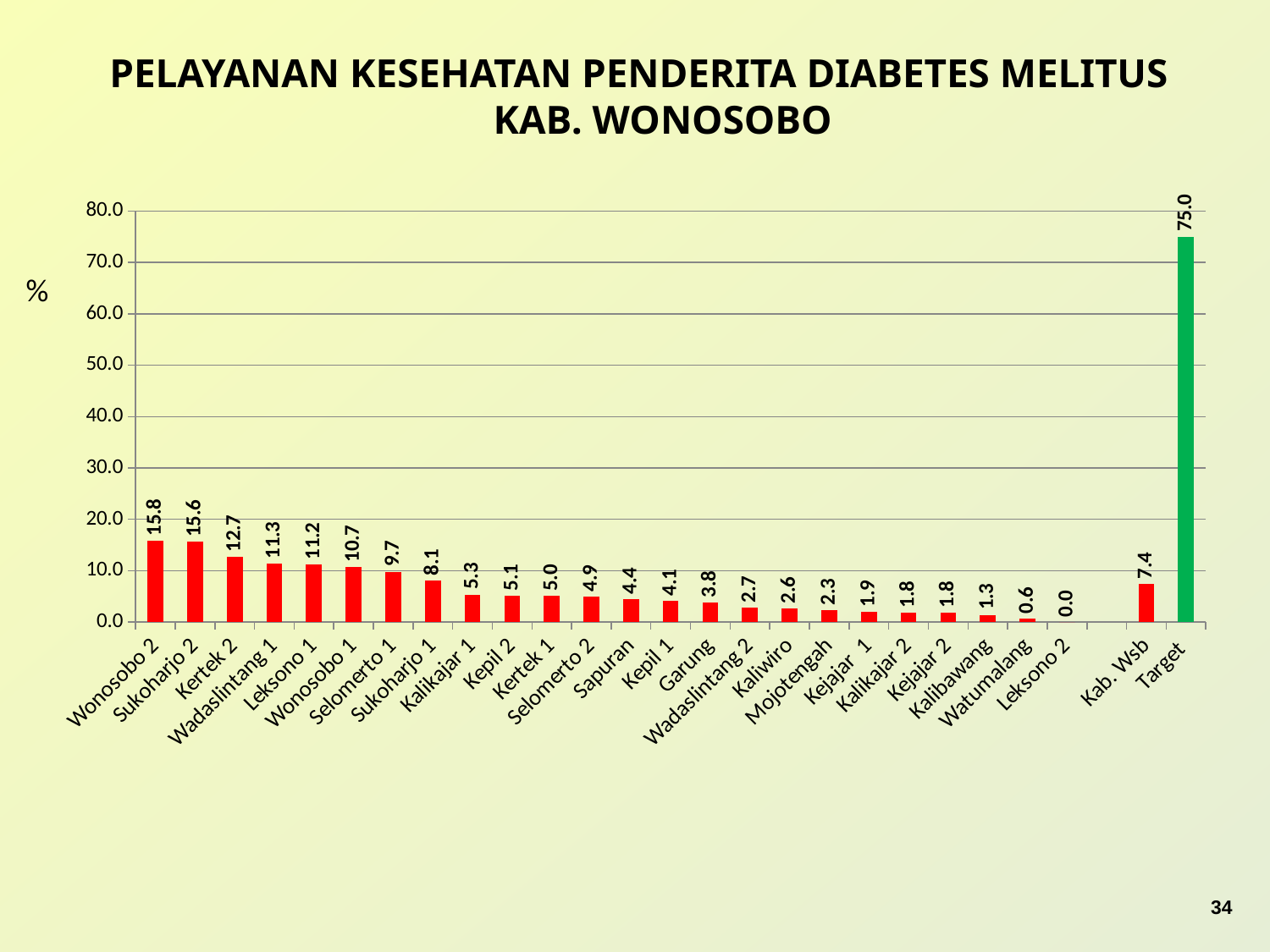
What is the value for Leksono 2? 0.0 What is the value for Wonosobo 2? 15.8 Which is larger, the value for Kertek 2 or the value for Wadaslintang 1? Kertek 2 What is the difference between Wonosobo 2 and Sukoharjo 2? 0.2 What kind of chart is shown on the slide? Bar chart Which category has the highest value? Target Which category has the lowest value? Leksono 2 What is the difference between the Target value and the Kab. Wsb value? 67.6 Is the value for Target greater or less than 70.0? greater How many categories are shown on the x axis? 26 What is the value for Target? 75.0 What is the value for Kab. Wsb? 7.4